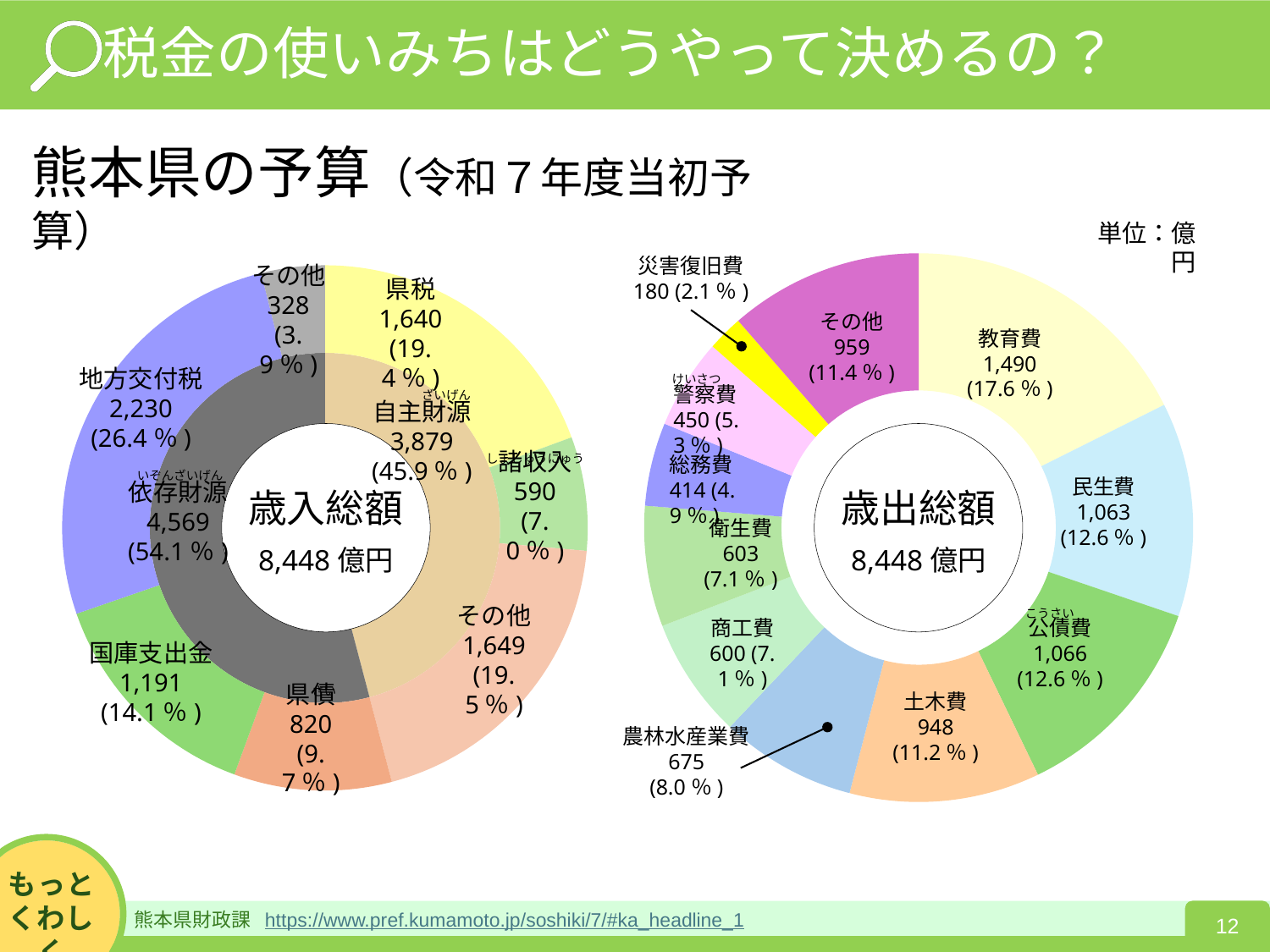
In the 歳出総額 chart on the right, which category has the smallest value? 災害復旧費 In the 歳出総額 chart on the right, what is the difference between 教育費 and 民生費? 427 In the 歳出総額 chart on the right, which is larger, 土木費 or 農林水産業費? 土木費 What kind of chart is used for 歳入総額 on the left? Donut (pie) chart In the 歳出総額 chart on the right, what percentage share is shown for 警察費? 5.3% In the 歳入総額 chart on the left, what is the value for 地方交付税? 2,230 In the 歳入総額 chart on the left, what percentage share is shown for 依存財源? 54.1% What total amount is shown in the centre of the 歳出総額 chart on the right? 8,448 億円 In the 歳入総額 chart on the left, which outer-ring category has the largest value? 地方交付税 In the 歳出総額 chart on the right, what is the value for 教育費? 1,490 In the 歳出総額 chart on the right, which category has the largest value? 教育費 In the 歳出総額 chart on the right, how many expenditure categories are shown? 11